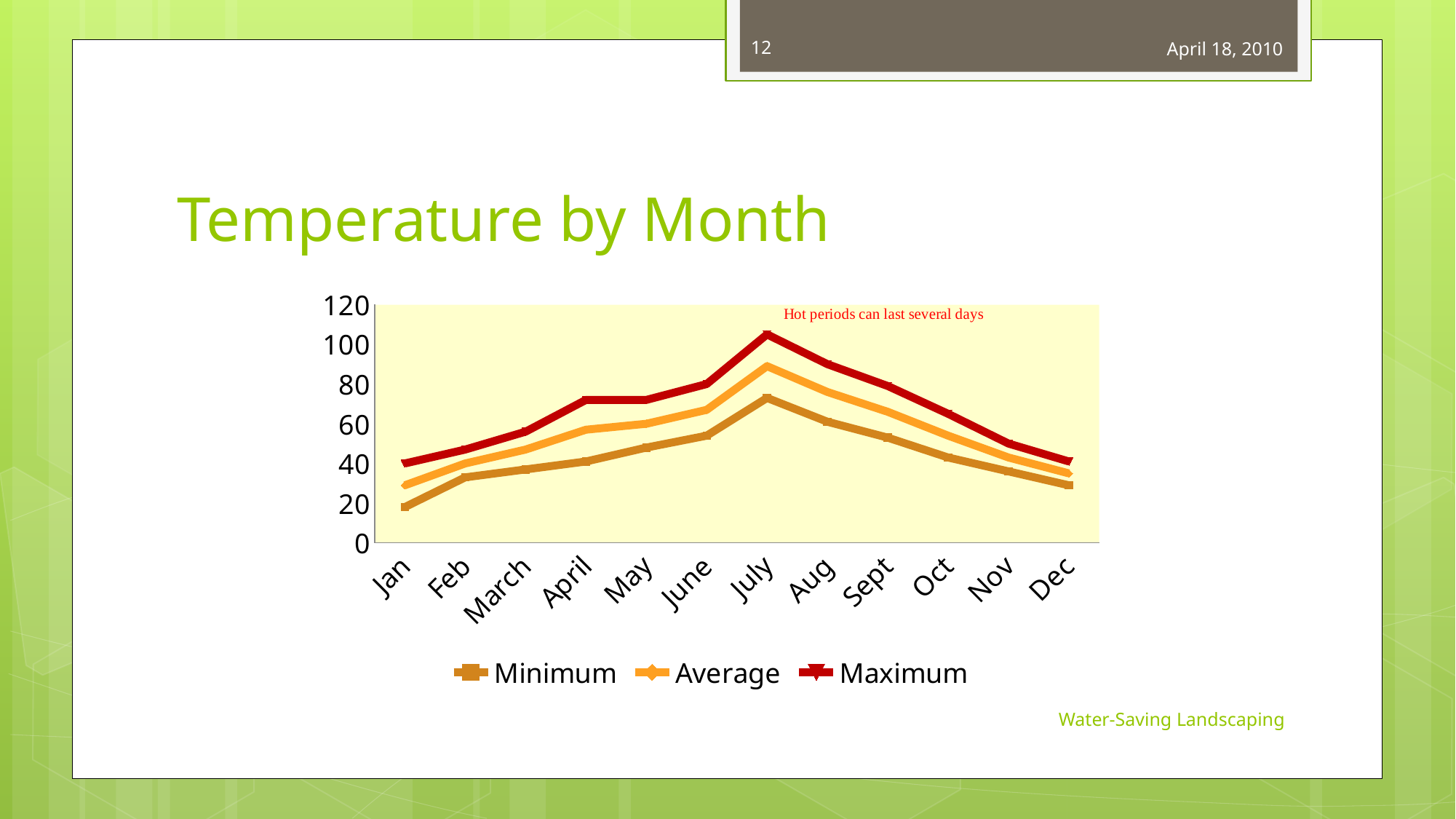
How many series does the legend list? 3 Do the Maximum values rise or fall from July to Dec? fall Is the Minimum value for July greater or less than 60? greater How many months are plotted along the x axis? 12 Is the Maximum value for Jan greater or less than 60? less Which is larger, the Maximum value for July or the Maximum value for Jan? July Is the Minimum value for Dec greater or less than 40? less What kind of chart is shown on the slide? line chart What is the title of the chart? Temperature by Month In which month does the Maximum series reach its highest value? July In which month is the Minimum series at its lowest value? Jan